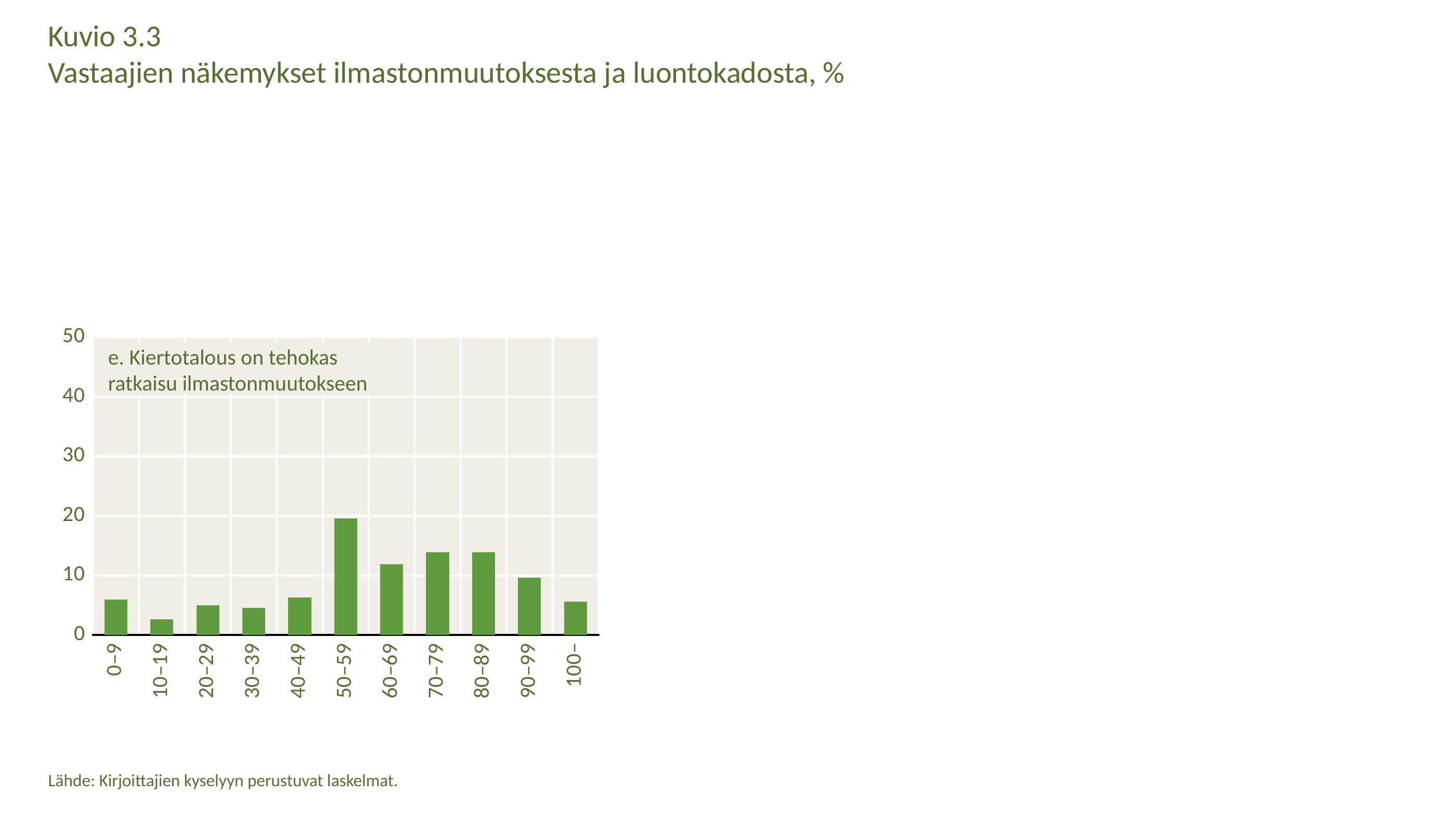
Which is larger, the value for 0–9 or the value for 10–19? 0–9 What is the figure number given in the slide title? Kuvio 3.3 Is the value for 60–69 greater or less than 10? greater What kind of chart is shown on the slide? bar chart Is the value for 10–19 greater or less than 10? less Which category has the highest bar in the chart? 50–59 Which category has the lowest bar in the chart? 10–19 Is the value for 70–79 greater or less than 20? less Which is larger, the value for 50–59 or the value for 60–69? 50–59 How many categories are shown on the x axis of the chart? 11 What is the label printed inside the plot area of the chart? e. Kiertotalous on tehokas ratkaisu ilmastonmuutokseen